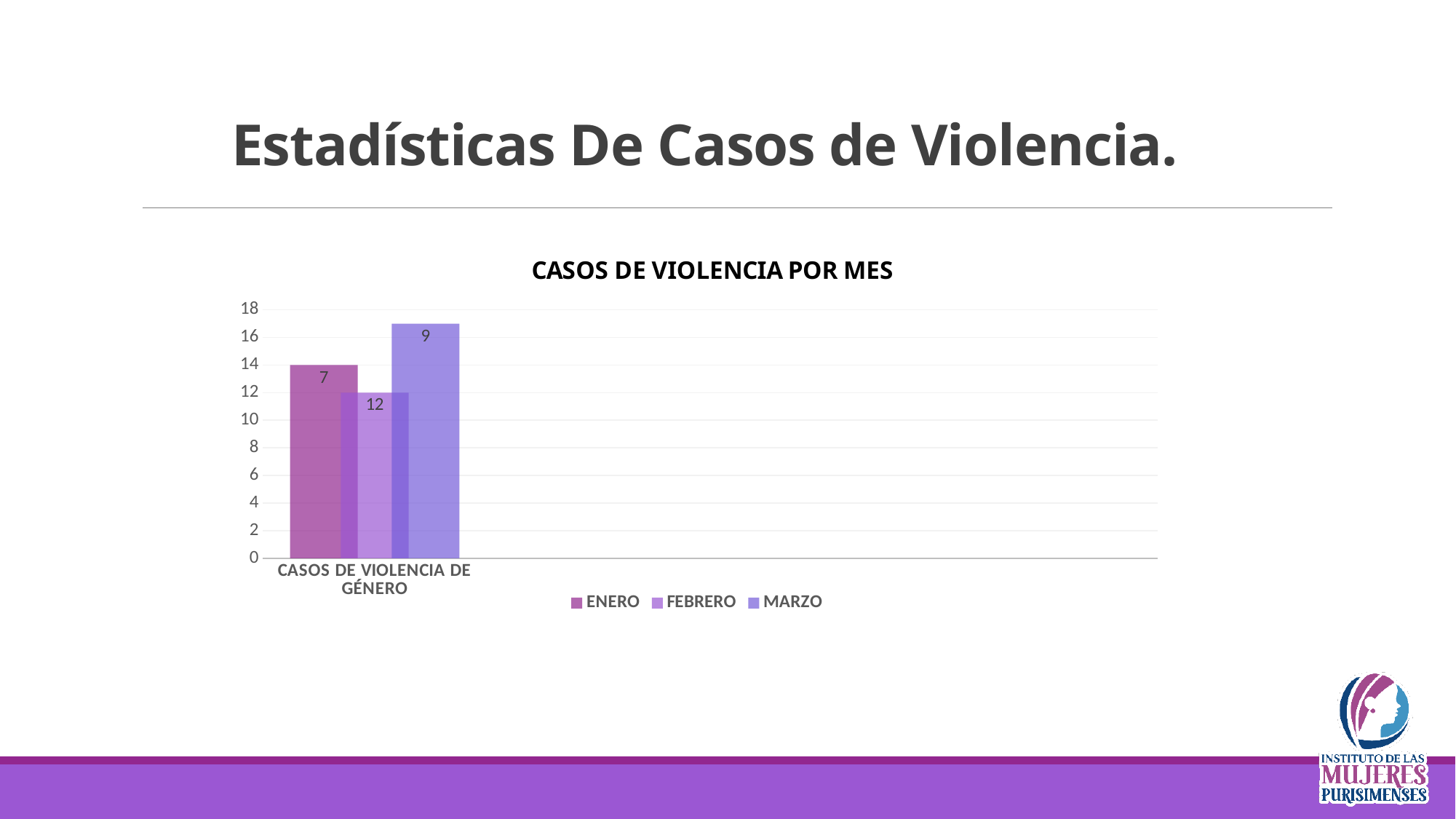
How many categories are shown on the x axis? 1 What kind of chart is shown on the slide? bar chart Which series are listed in the legend? ENERO, FEBRERO, MARZO What data label is printed on the MARZO bar? 9 What is the highest value shown on the y axis? 18 How many series does the legend list? 3 What data label is printed on the ENERO bar? 7 What is the label of the category on the x axis? CASOS DE VIOLENCIA DE GÉNERO What data label is printed on the FEBRERO bar? 12 What is the title of the chart? CASOS DE VIOLENCIA POR MES